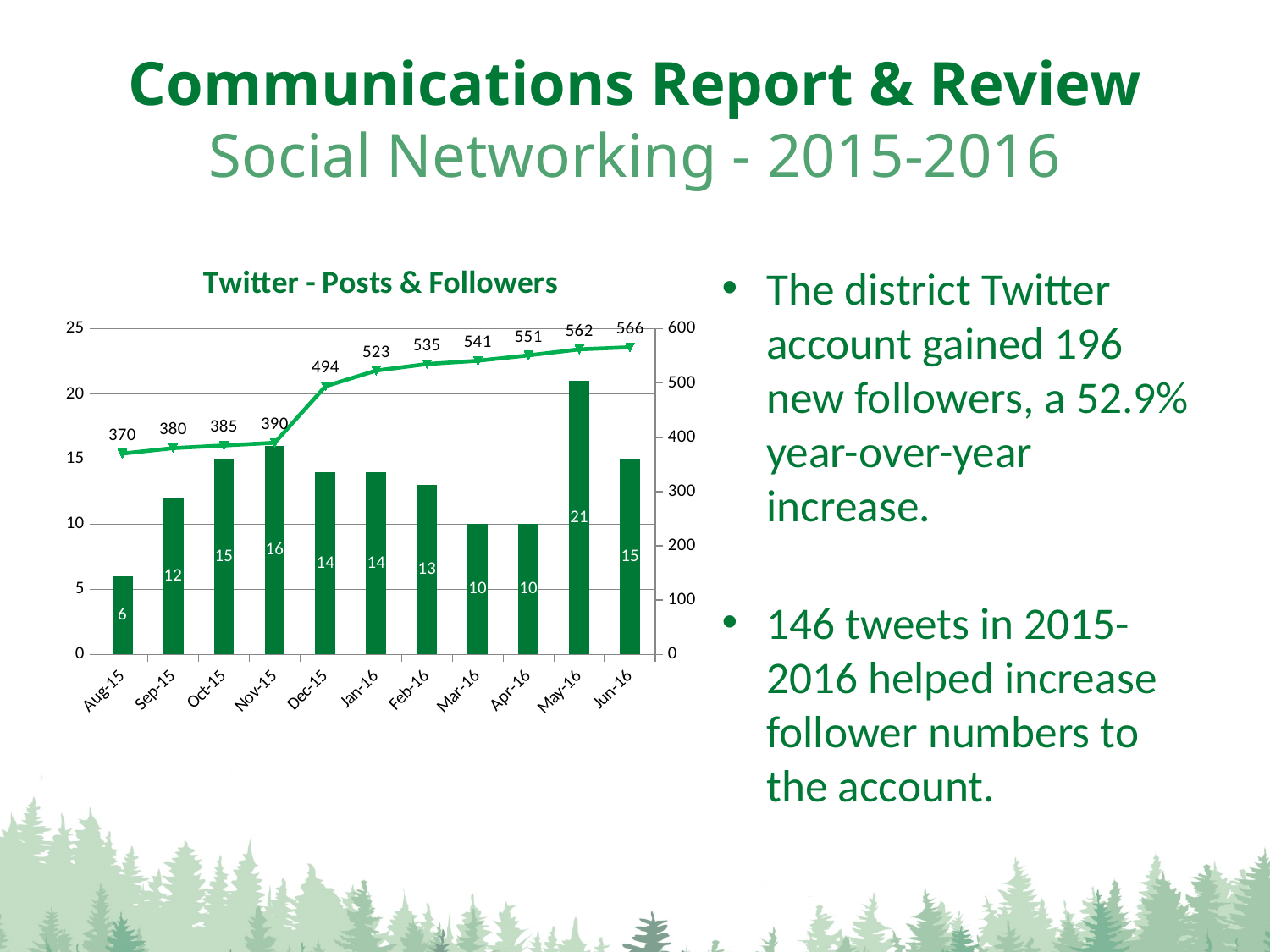
Is the follower value for Nov-15 greater or less than 400? less Which month has more posts, Sep-15 or Feb-16? Feb-16 Does the followers line rise or fall from Aug-15 to Jun-16? rise What is the difference in posts between May-16 and Apr-16? 11 How many months are shown on the x axis? 11 Which month has the lowest bar for posts? Aug-15 What is the difference between the follower values for Jun-16 and Aug-15? 196 What is the title of the chart? Twitter - Posts & Followers Which month has the highest bar for posts? May-16 How many posts does the bar for May-16 show? 21 What kind of chart is used for the posts data? bar chart What is the follower value plotted on the line for Dec-15? 494